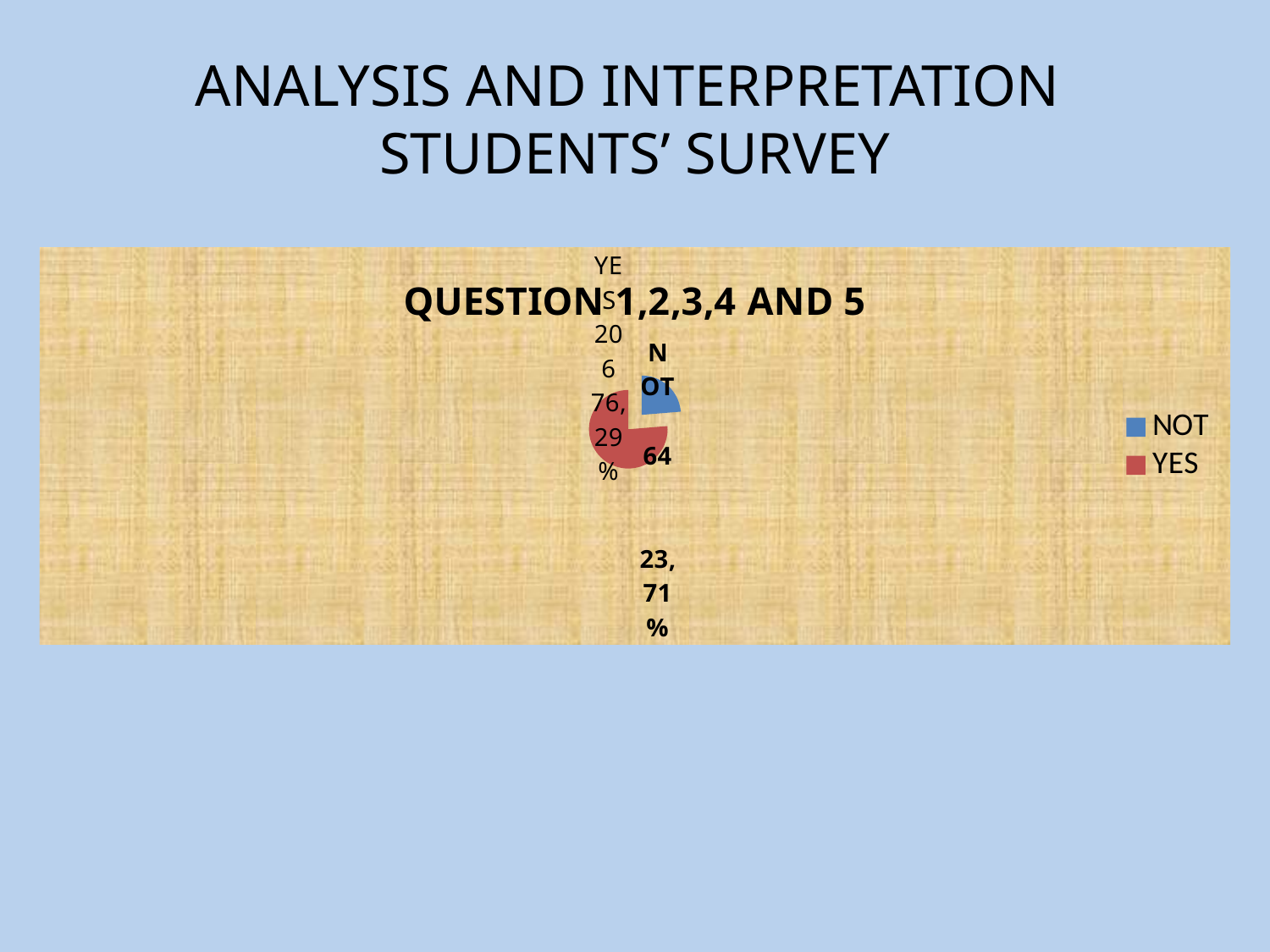
Which category has the largest slice of the pie? YES What share of the pie does the NOT slice represent? 23,71% What is the title of the chart? QUESTION 1,2,3,4 AND 5 Which category has the smallest slice of the pie? NOT How many entries does the chart legend list? 2 What is the value shown for the NOT slice? 64 What kind of chart is shown on the slide? pie chart What is the value shown for the YES slice? 206 How many slices does the pie chart have? 2 What is the difference between the YES value and the NOT value? 142 What share of the pie does the YES slice represent? 76,29% Which is larger, the value for YES or the value for NOT? YES